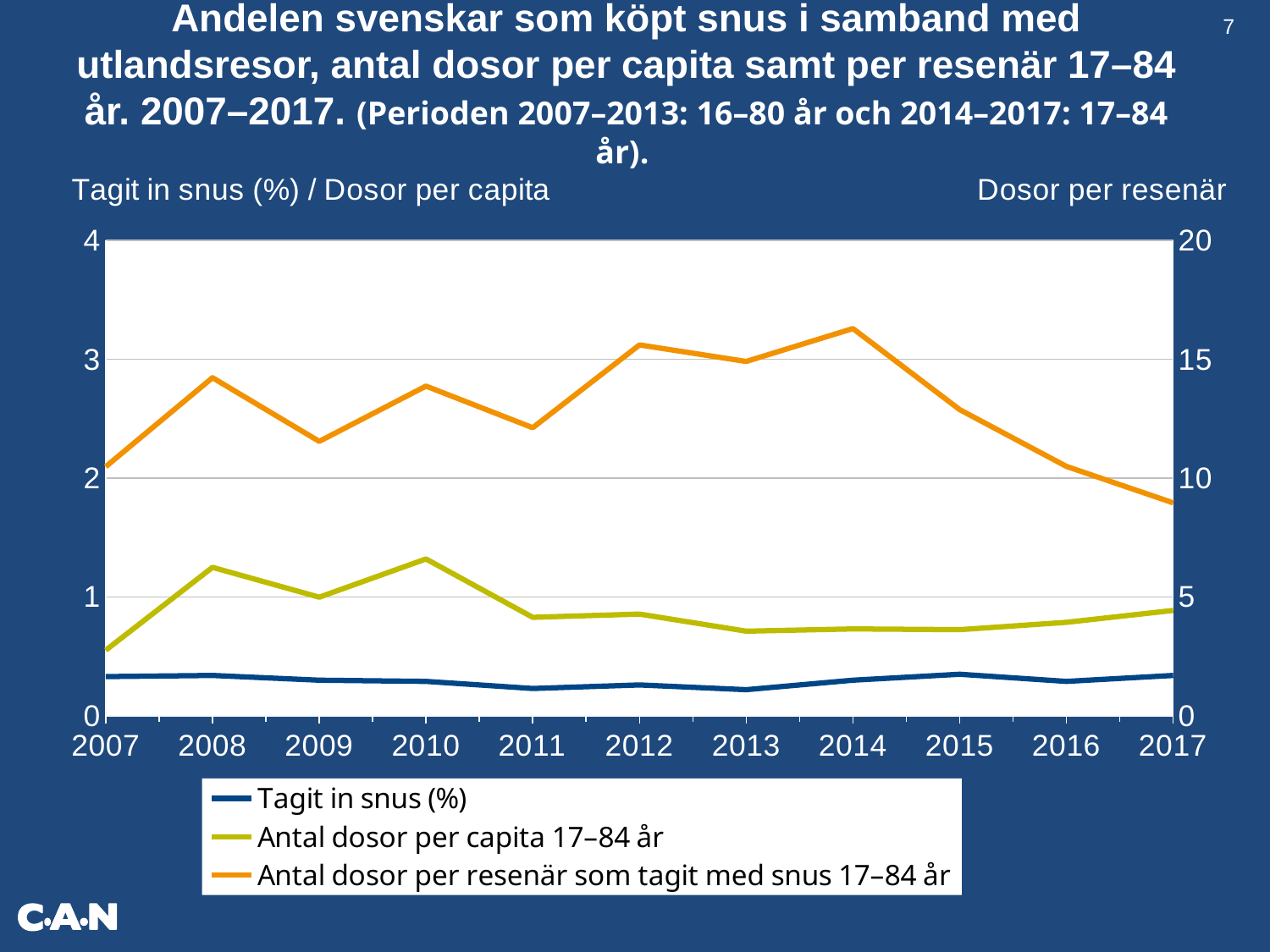
How many series does the legend list? 3 Is the value for 'Antal dosor per resenär som tagit med snus 17–84 år' in 2017 greater or less than 10 on the right axis? less Is the value for 'Antal dosor per capita 17–84 år' in 2013 greater or less than 1 on the left axis? less In which year is the series 'Antal dosor per resenär som tagit med snus 17–84 år' at its lowest? 2017 In which year is the series 'Antal dosor per capita 17–84 år' at its lowest? 2007 In which year does the series 'Antal dosor per resenär som tagit med snus 17–84 år' reach its highest value? 2014 Which is larger for 'Antal dosor per resenär som tagit med snus 17–84 år': the value in 2012 or the value in 2009? 2012 Does the series 'Antal dosor per resenär som tagit med snus 17–84 år' rise or fall from 2014 to 2017? fall How many years are plotted along the x axis? 11 What kind of chart is shown on the slide? line chart What is the title of the right-hand axis? Dosor per resenär Is the value for 'Antal dosor per resenär som tagit med snus 17–84 år' in 2014 greater or less than 15 on the right axis? greater